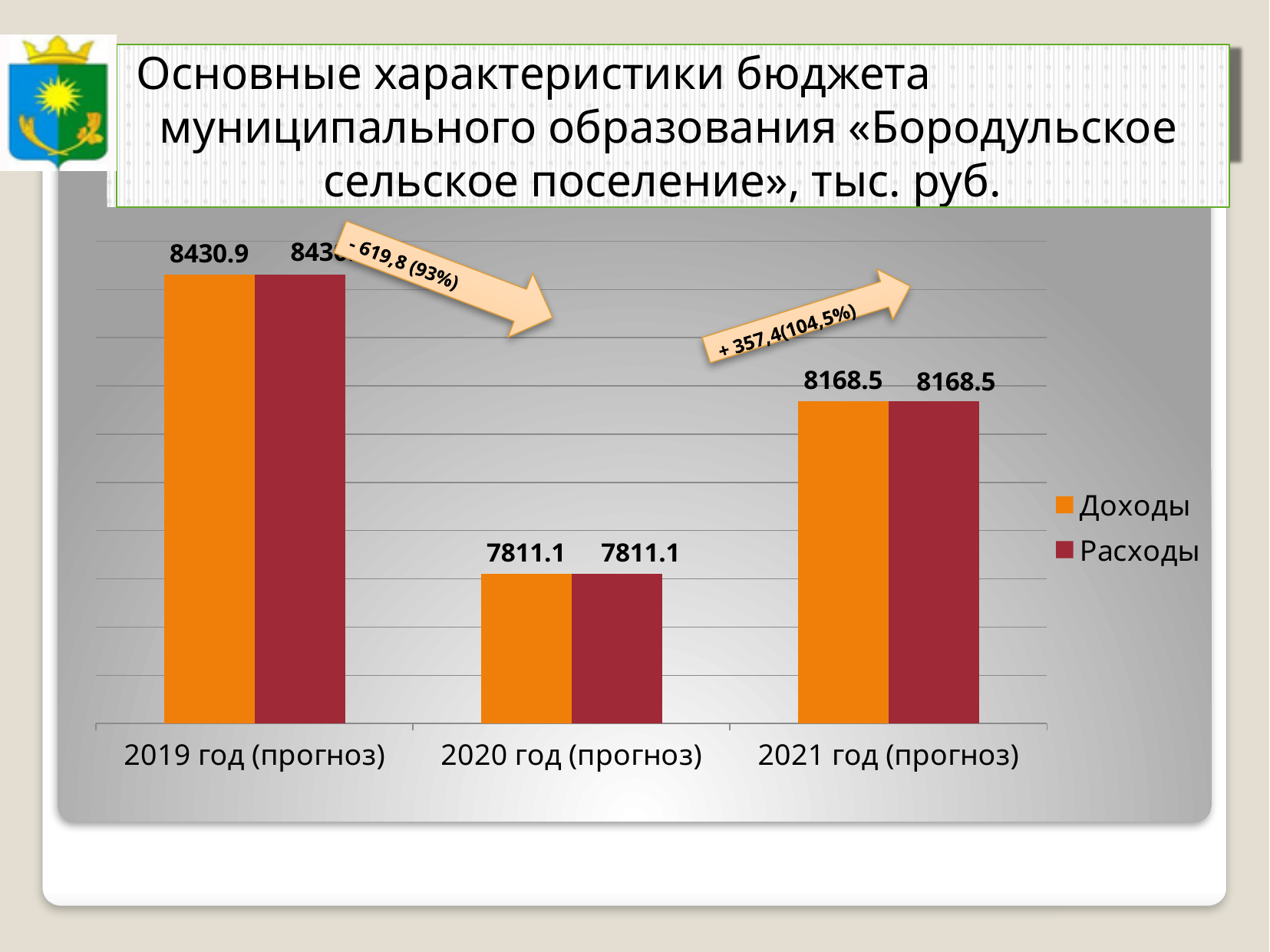
What is the difference between Доходы in 2019 год (прогноз) and Доходы in 2021 год (прогноз)? 262.4 What is the value of Доходы for 2021 год (прогноз)? 8168.5 In which year is Доходы highest? 2019 год (прогноз) What is the value of Доходы for 2019 год (прогноз)? 8430.9 What kind of chart is shown on the slide? bar chart How many year categories are shown on the x axis? 3 What is the value of Расходы for 2020 год (прогноз)? 7811.1 What is the difference between Доходы in 2021 год (прогноз) and Доходы in 2020 год (прогноз)? 357.4 In which year is Доходы lowest? 2020 год (прогноз) How many series does the legend list? 2 What is the value of Расходы for 2021 год (прогноз)? 8168.5 Which is larger: Расходы in 2020 год (прогноз) or Расходы in 2021 год (прогноз)? 2021 год (прогноз)